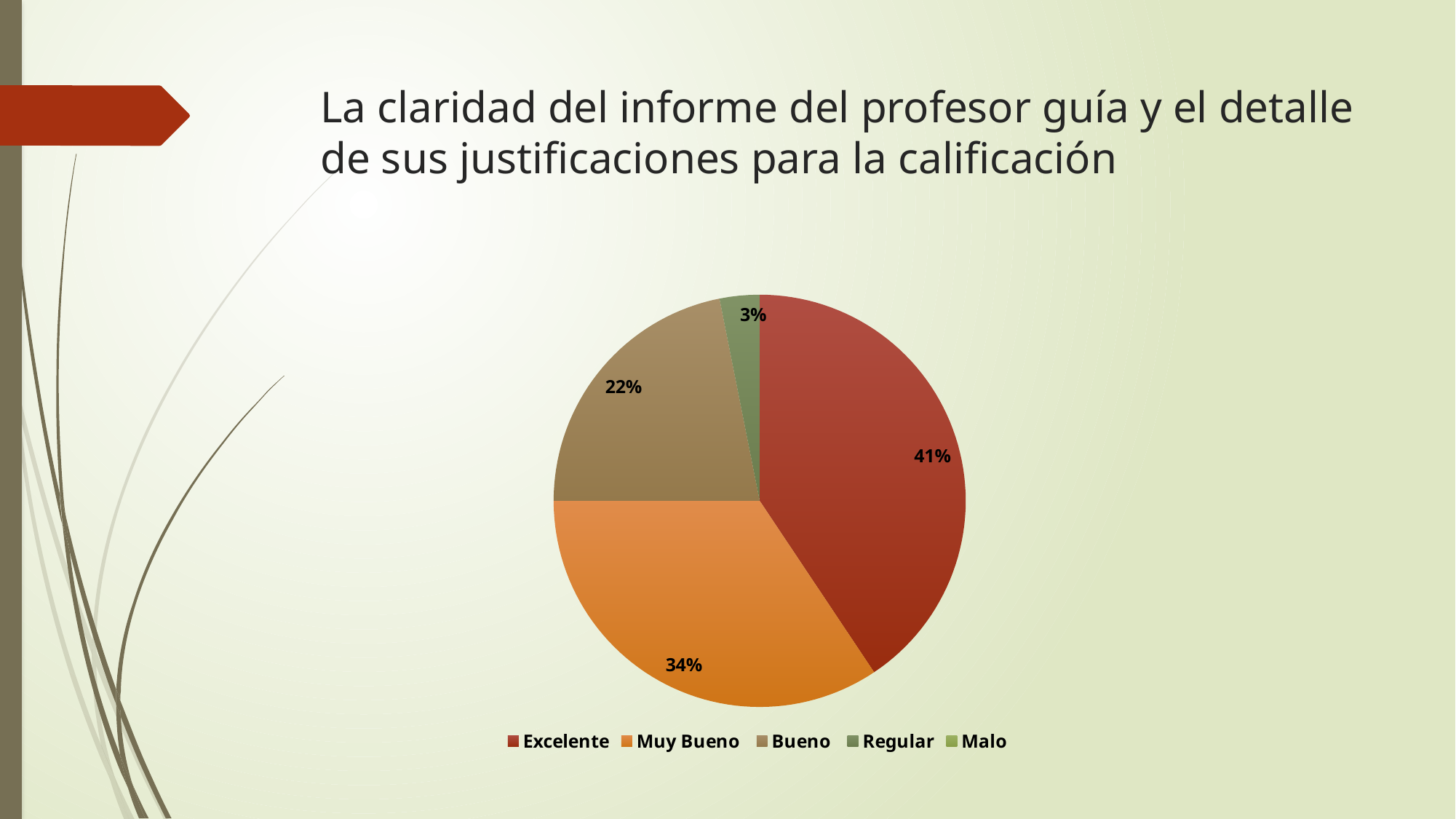
Which labelled slice of the pie is the smallest? Regular What percentage of the pie is the Muy Bueno slice? 34% What percentage of the pie is the Regular slice? 3% How many entries does the legend list? 5 What type of chart is shown on the slide? pie chart Which category has the largest slice of the pie? Excelente What colour is the Excelente slice in the pie chart? red What percentage of the pie is the Excelente slice? 41% Which slice is larger, Bueno or Muy Bueno? Muy Bueno What is the difference in percentage points between the Excelente and Muy Bueno slices? 7 What percentage of the pie is the Bueno slice? 22% How many slices of the pie have a percentage label? 4